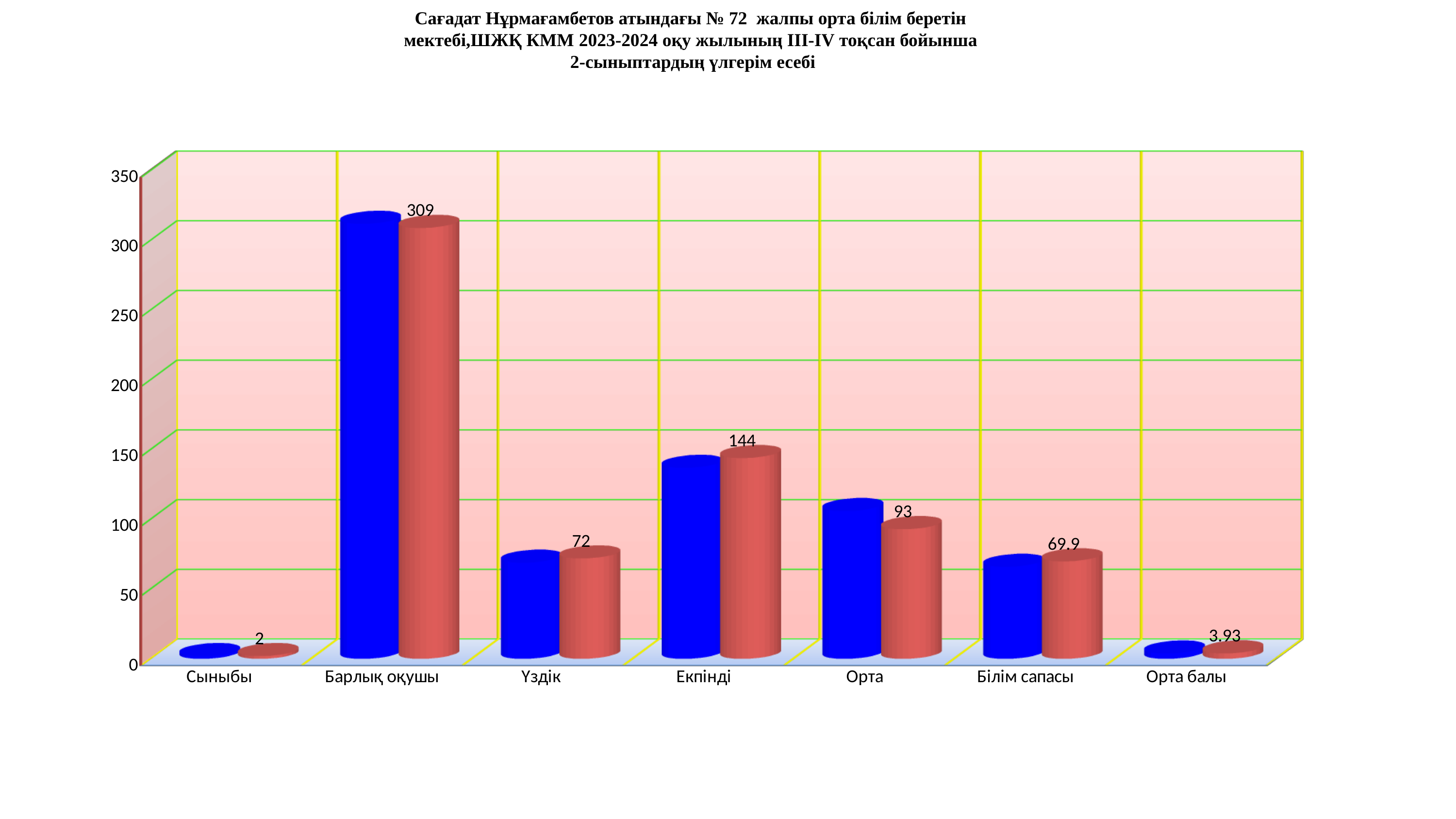
What is the highest value shown on the vertical axis? 350 Which category has the lowest labelled red bar? Сыныбы What kind of chart is shown on the slide? bar chart Which category has the highest labelled red bar? Барлық оқушы How many categories are shown on the x axis? 7 What value is labelled on the red bar for Білім сапасы? 69.9 What value is labelled on the red bar for Барлық оқушы? 309 What value is labelled on the red bar for Екпінді? 144 Which labelled red bar is larger, Үздік or Орта? Орта Is the blue bar for Екпінді greater or less than 100? greater What value is labelled on the red bar for Орта балы? 3.93 What is the difference between the labelled red-bar values for Екпінді and Орта? 51